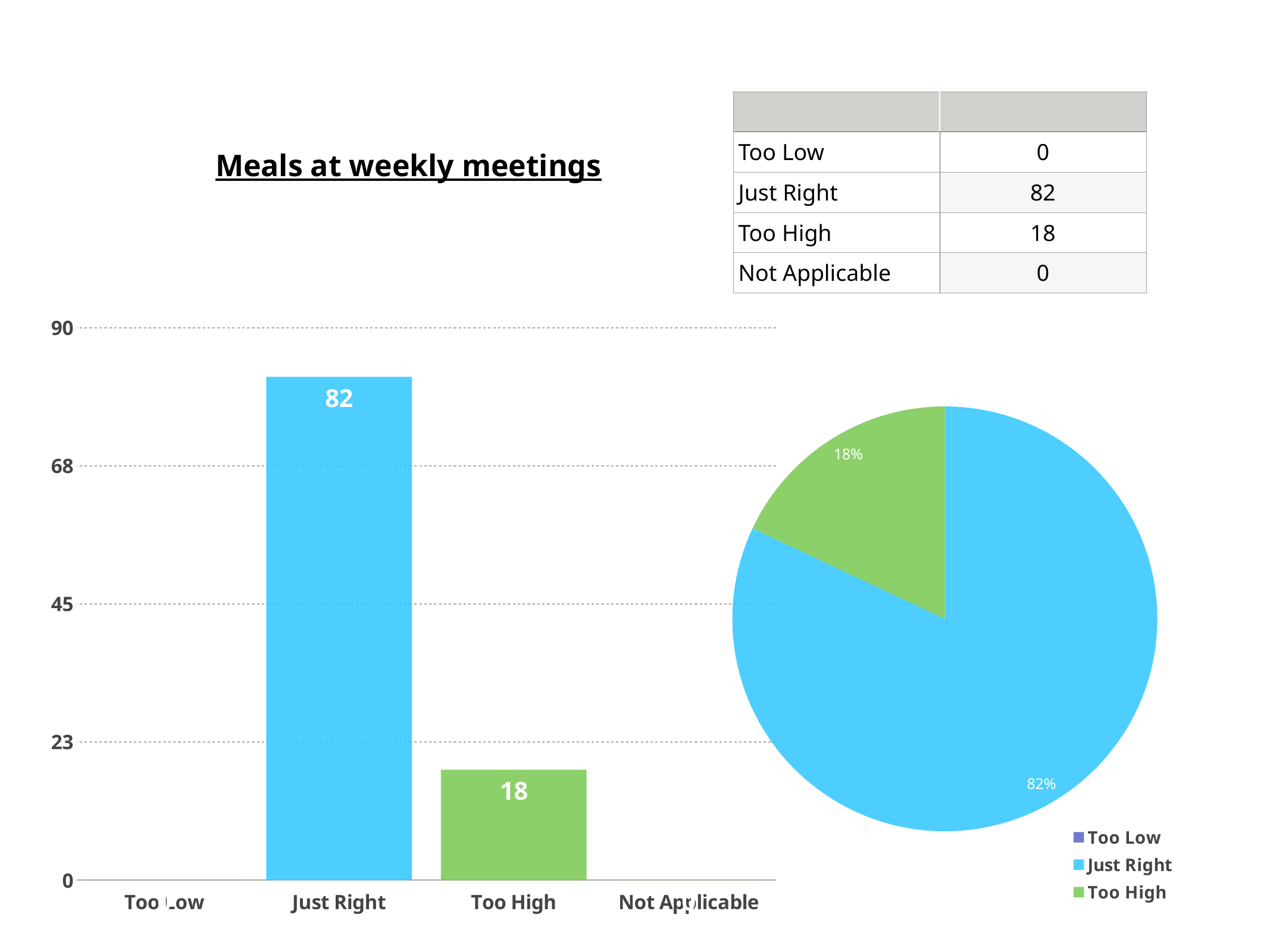
In the pie chart, what share does Just Right have? 82% In the bar chart, is the value for Too High greater or less than 23? less In the bar chart, which category has the highest value? Just Right What kind of chart is the chart on the left of the slide? bar chart In the bar chart, what is the difference between the values for Just Right and Too High? 64 How many categories are shown on the x axis of the bar chart? 4 In the bar chart, what is the value for Just Right? 82 In the bar chart, which is larger, the value for Just Right or the value for Too High? Just Right In the bar chart, what is the value for Too High? 18 How many entries does the legend of the pie chart list? 3 In the pie chart, what share does Too High have? 18% What kind of chart is the chart on the right of the slide? pie chart